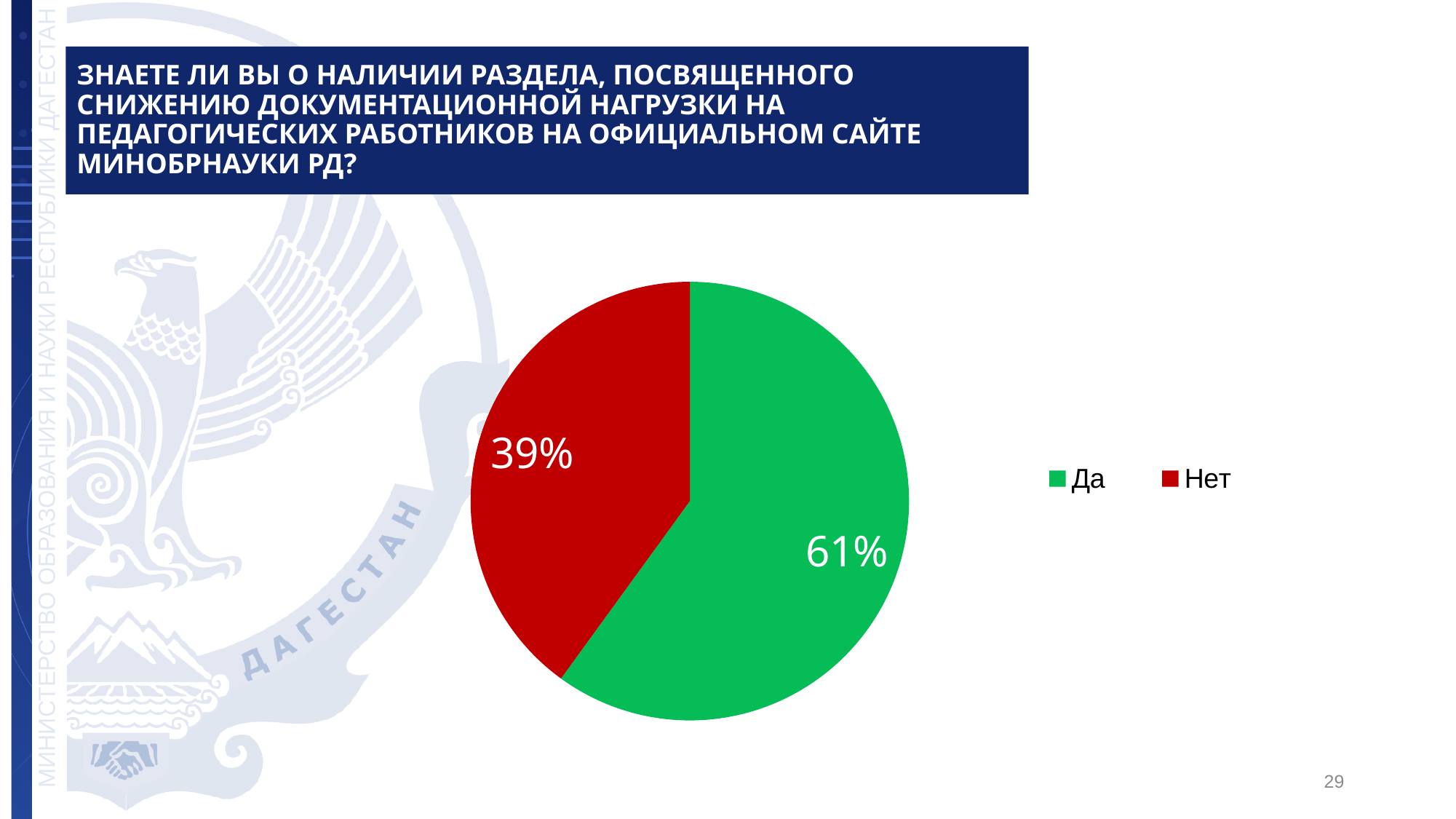
Which answer has the smallest share of the pie? Нет What colour is the "Да" slice? Green What share of the pie does the "Нет" slice represent? 39% How many entries does the legend list? 2 How many slices does the pie chart have? 2 Which slice is larger, "Да" or "Нет"? Да Which answer has the largest share of the pie? Да What percentage of respondents answered "Да"? 61% What colour is the "Нет" slice? Red What type of chart is shown on the slide? Pie chart What is the difference in percentage points between the "Да" and "Нет" slices? 22 What percentage of respondents answered "Нет"? 39%